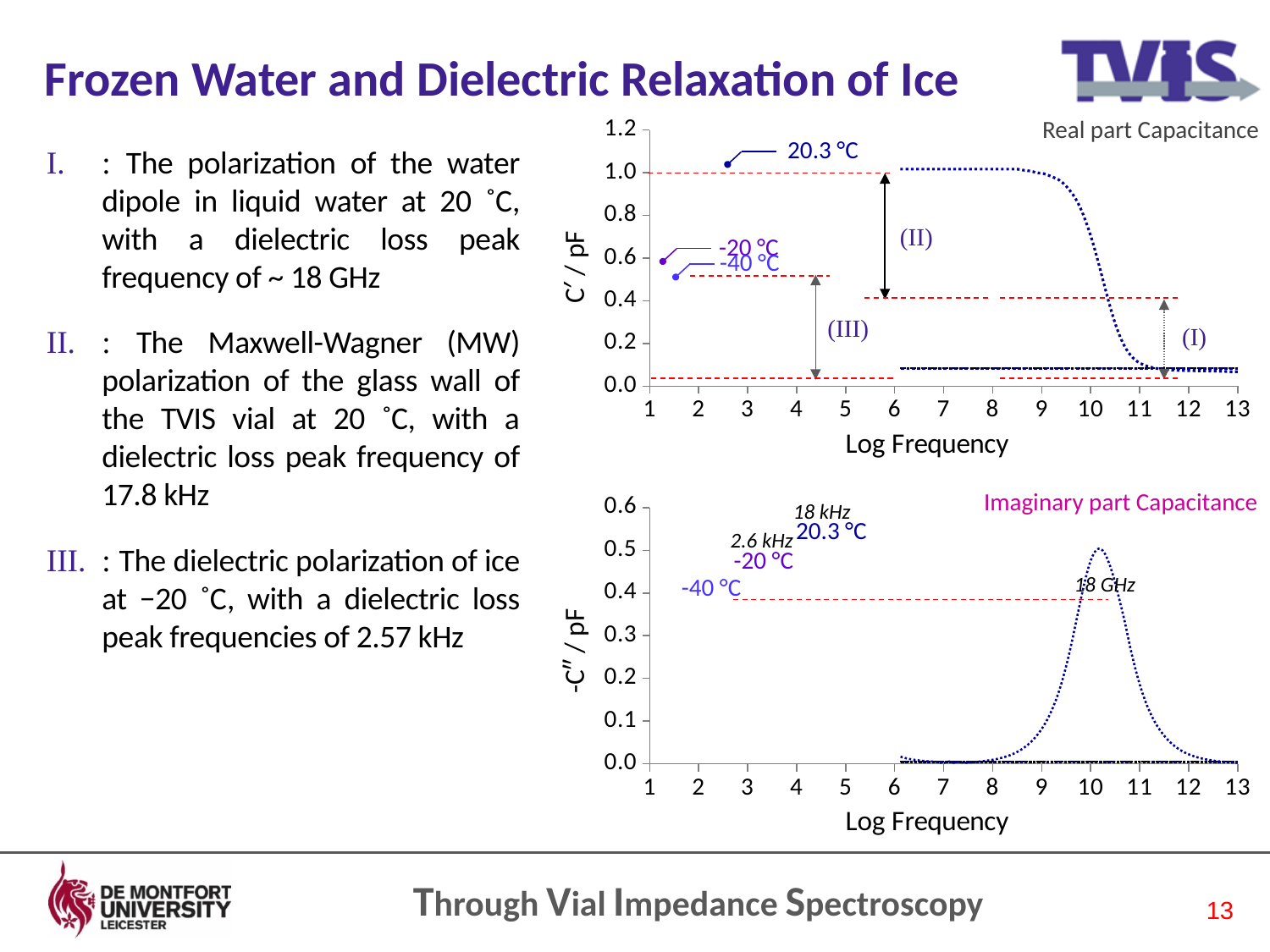
In the top chart (Real part Capacitance), is the value of the 20.3 °C curve at log frequency 12 greater or less than 0.2? less In the bottom chart (Imaginary part Capacitance), is the peak value of the 20.3 °C curve near log frequency 10 greater or less than 0.4? greater In the bottom chart (Imaginary part Capacitance), what frequency is labelled at the peak of the 20.3 °C curve? 18 GHz What kind of chart is the top chart titled "Real part Capacitance"? line chart What kind of chart is the bottom chart titled "Imaginary part Capacitance"? line chart In the top chart (Real part Capacitance), how many temperature series are labelled? 3 In the bottom chart (Imaginary part Capacitance), what peak frequency is labelled for the -20 °C series? 2.6 kHz In the bottom chart (Imaginary part Capacitance), what is the label on the y axis? -C'' / pF In the top chart (Real part Capacitance), what is the highest value shown on the y axis? 1.2 In the top chart (Real part Capacitance), does the 20.3 °C curve rise or fall as log frequency increases from 9 to 11? fall In the top chart (Real part Capacitance), what is the label on the x axis? Log Frequency In the top chart (Real part Capacitance), is the value of the 20.3 °C curve at log frequency 7 greater or less than 0.8? greater